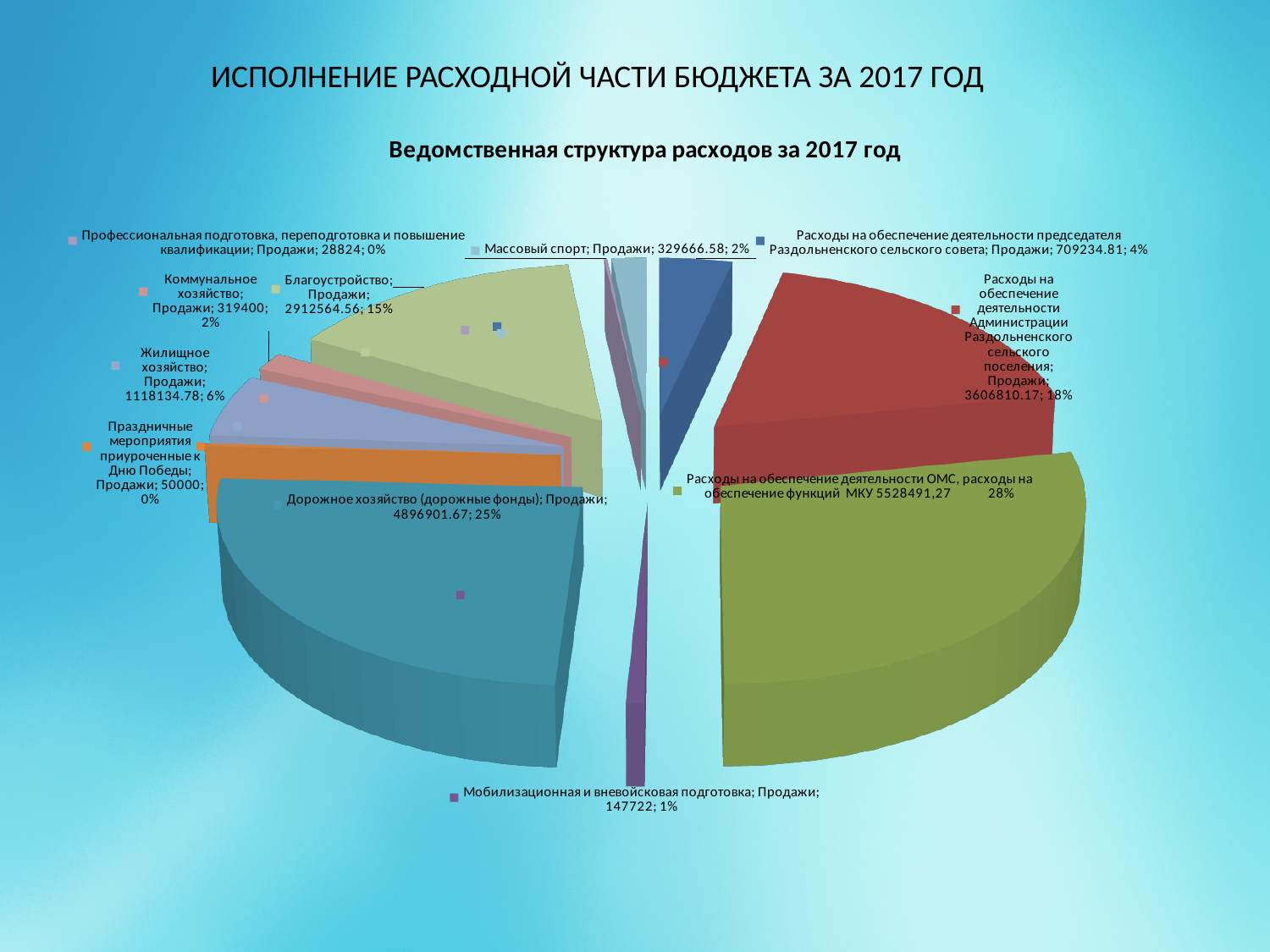
What is the value for Благоустройство? 2912564.56 Which category has the largest share of the pie? Расходы на обеспечение деятельности ОМС, расходы на обеспечение функций МКУ What is the title of the chart? Ведомственная структура расходов за 2017 год What is the value for Дорожное хозяйство (дорожные фонды)? 4896901.67 What is the difference between the values for Дорожное хозяйство (дорожные фонды) and Благоустройство? 1984337.11 Which is larger: the value for Коммунальное хозяйство or the value for Мобилизационная и вневойсковая подготовка? Коммунальное хозяйство What is the value for Массовый спорт? 329666.58 What kind of chart is shown on the slide? pie chart Which category has the smallest value? Профессиональная подготовка, переподготовка и повышение квалификации What share of the pie does Расходы на обеспечение деятельности Администрации Раздольненского сельского поселения represent? 18% What share of the pie does Жилищное хозяйство represent? 6% How many slices does the pie chart have? 11